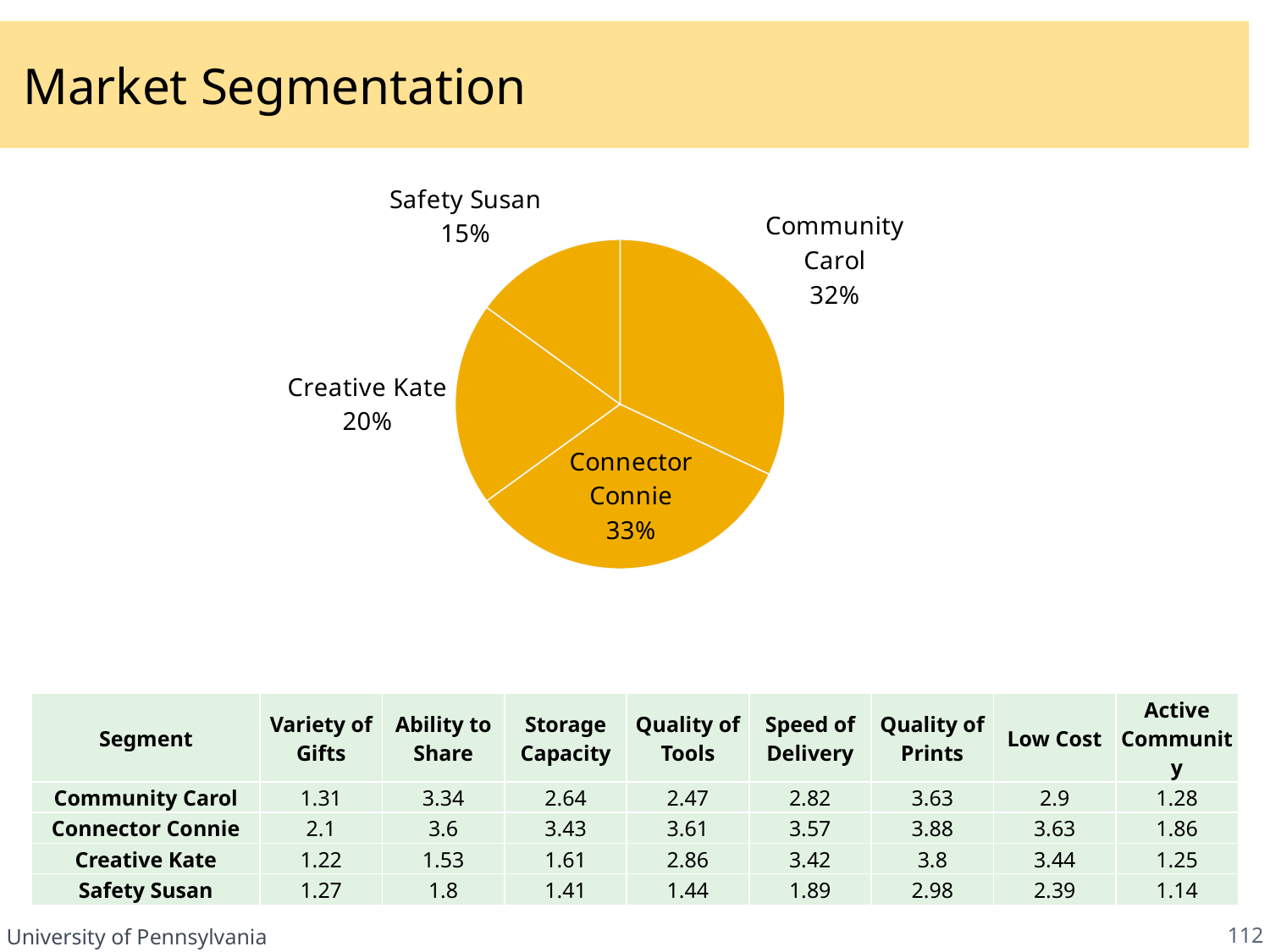
What share of the pie does Safety Susan hold? 15% What is the title of the slide containing the pie chart? Market Segmentation How many segments are shown in the pie chart? 4 What share of the pie does Creative Kate hold? 20% Which segment has the largest slice of the pie? Connector Connie What is the difference in percentage points between Connector Connie and Safety Susan? 18 Which segment has the smallest slice of the pie? Safety Susan Which slice is larger, Creative Kate or Safety Susan? Creative Kate What is the difference in percentage points between Community Carol and Creative Kate? 12 What share of the pie does Connector Connie hold? 33% What kind of chart is shown on the slide? pie chart